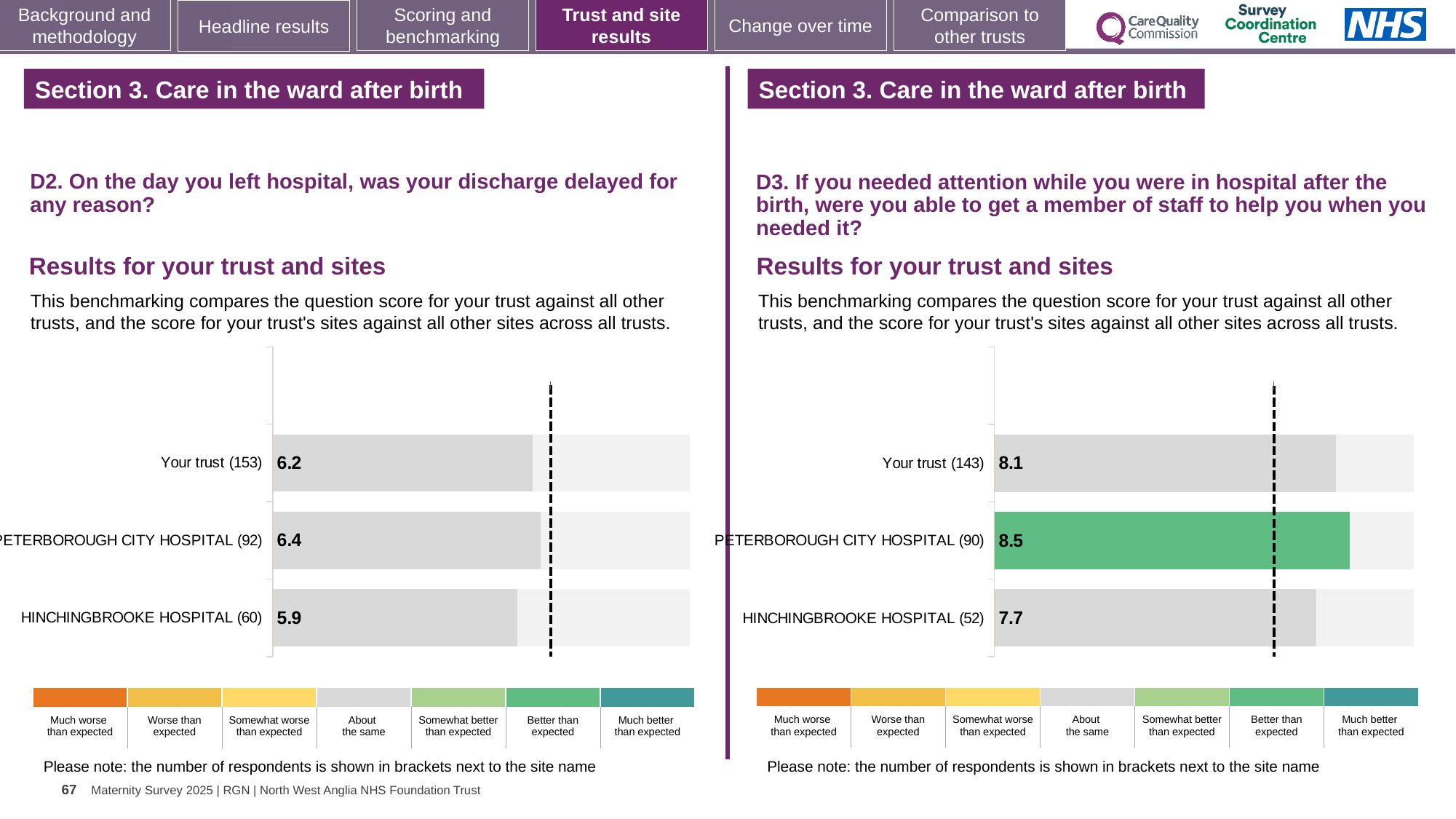
In the right chart (D3, able to get a member of staff to help), what is the difference between the scores for Your trust and HINCHINGBROOKE HOSPITAL? 0.4 In the right chart (D3, able to get a member of staff to help), what is the score for PETERBOROUGH CITY HOSPITAL? 8.5 In the right chart (D3), how many respondents are shown in brackets for HINCHINGBROOKE HOSPITAL? 52 In the left chart (D2, discharge delayed), what is the score for HINCHINGBROOKE HOSPITAL? 5.9 In the right chart (D3, able to get a member of staff to help), what is the score for Your trust? 8.1 What kind of chart is used on the left side of the slide for D2? Bar chart In the right chart (D3, able to get a member of staff to help), which has the larger score: Your trust or PETERBOROUGH CITY HOSPITAL? PETERBOROUGH CITY HOSPITAL In the left chart (D2, discharge delayed), which site or trust has the highest score? PETERBOROUGH CITY HOSPITAL In the left chart (D2, discharge delayed), what is the score for Your trust? 6.2 In the left chart (D2, discharge delayed), what is the difference between the scores for PETERBOROUGH CITY HOSPITAL and HINCHINGBROOKE HOSPITAL? 0.5 In the left chart (D2, discharge delayed), how many bars are plotted? 3 In the right chart (D3, able to get a member of staff to help), which site or trust has the lowest score? HINCHINGBROOKE HOSPITAL